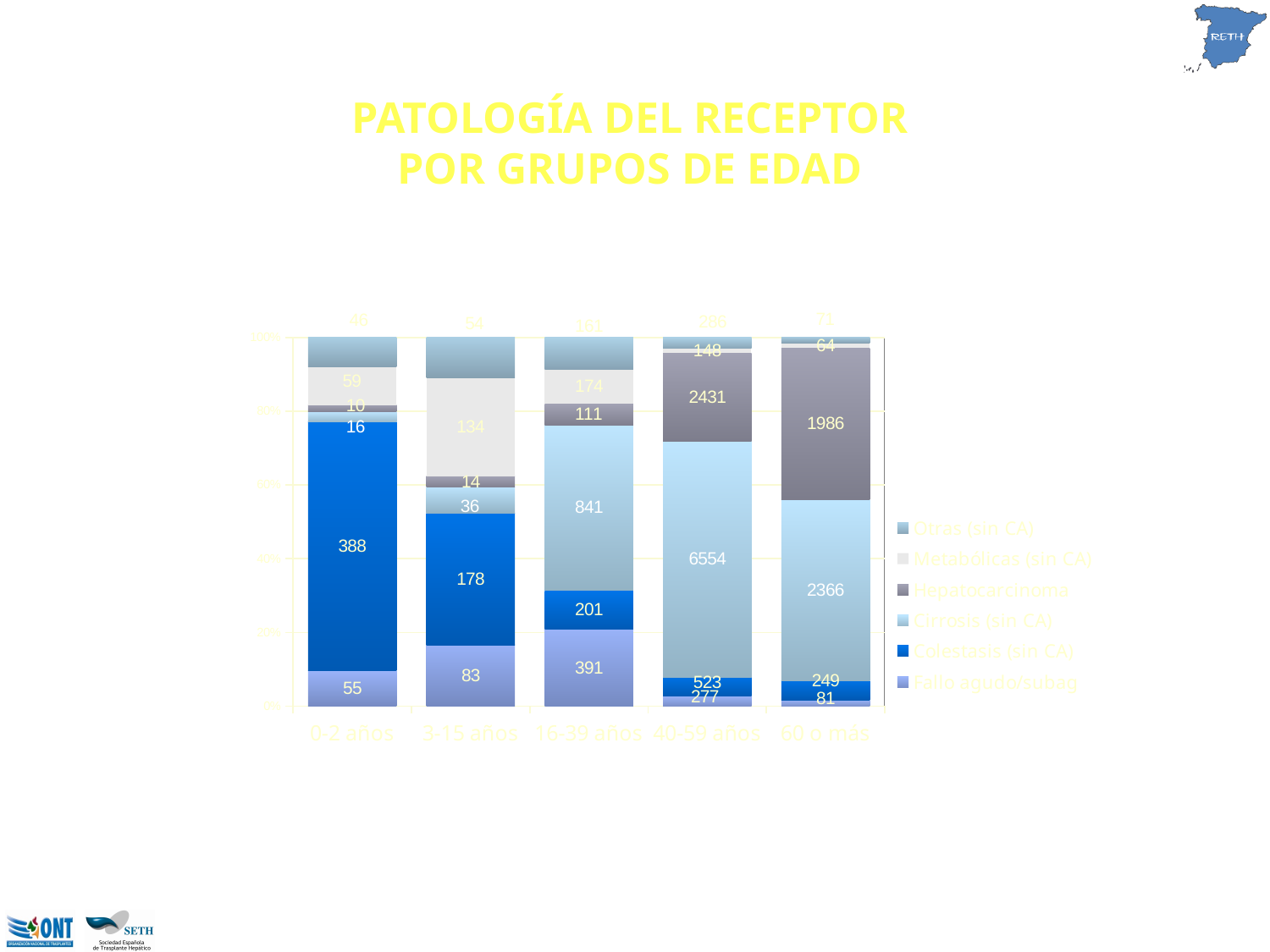
How many age groups are shown on the x axis? 5 Which age group has the lowest value for Hepatocarcinoma? 0-2 años How many series does the legend list? 6 What type of chart is shown on the slide? Stacked bar chart What is the difference between the Cirrosis (sin CA) values for 40-59 años and 60 o más? 4188 Which age group has the highest value for Cirrosis (sin CA)? 40-59 años Which is larger: Colestasis (sin CA) for 3-15 años or Colestasis (sin CA) for 16-39 años? 16-39 años What is the value for Fallo agudo/subag in the 16-39 años group? 391 What is the value for Cirrosis (sin CA) in the 40-59 años group? 6554 What is the title of the chart? PATOLOGÍA DEL RECEPTOR POR GRUPOS DE EDAD What is the value for Colestasis (sin CA) in the 0-2 años group? 388 What is the value for Hepatocarcinoma in the 60 o más group? 1986